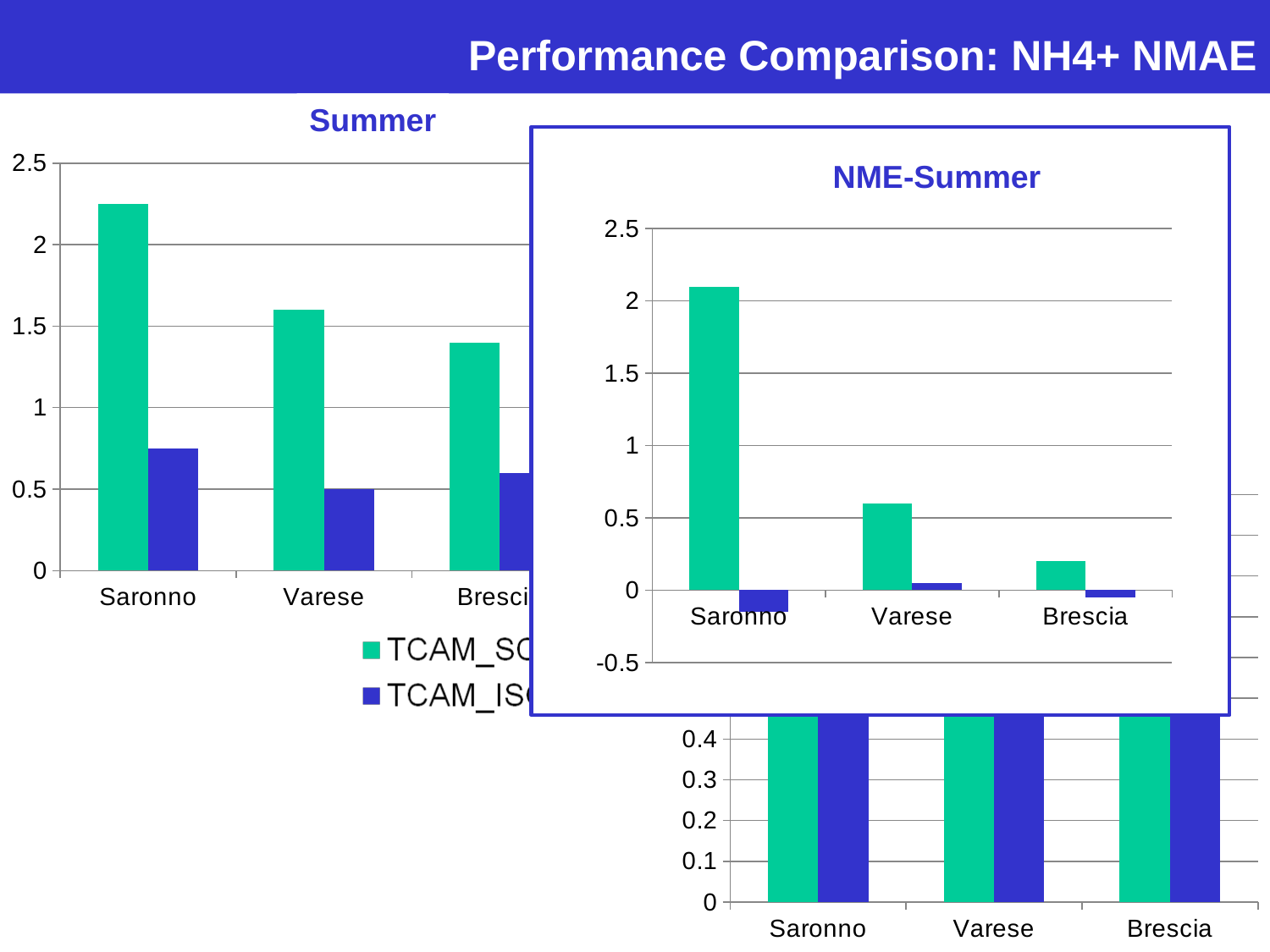
In the NME-Summer chart, is the green bar for Saronno greater or less than 2? greater In the Summer chart, is the green bar for Saronno greater or less than 2? greater In the NME-Summer chart, which category has the shortest green bar? Brescia In the Summer chart, is the blue bar for Varese greater or less than 1? less What is the title of the chart overlaid in the centre-right of the slide? NME-Summer In the Summer chart, what kind of chart is shown? bar chart In the NME-Summer chart, how many categories are shown on the x axis? 3 In the NME-Summer chart, which category has the tallest green bar? Saronno In the Summer chart, do the green bars rise or fall from Saronno to Brescia? fall In the Summer chart, which green bar is taller, Varese or Brescia? Varese In the Summer chart, which category has the tallest green bar? Saronno